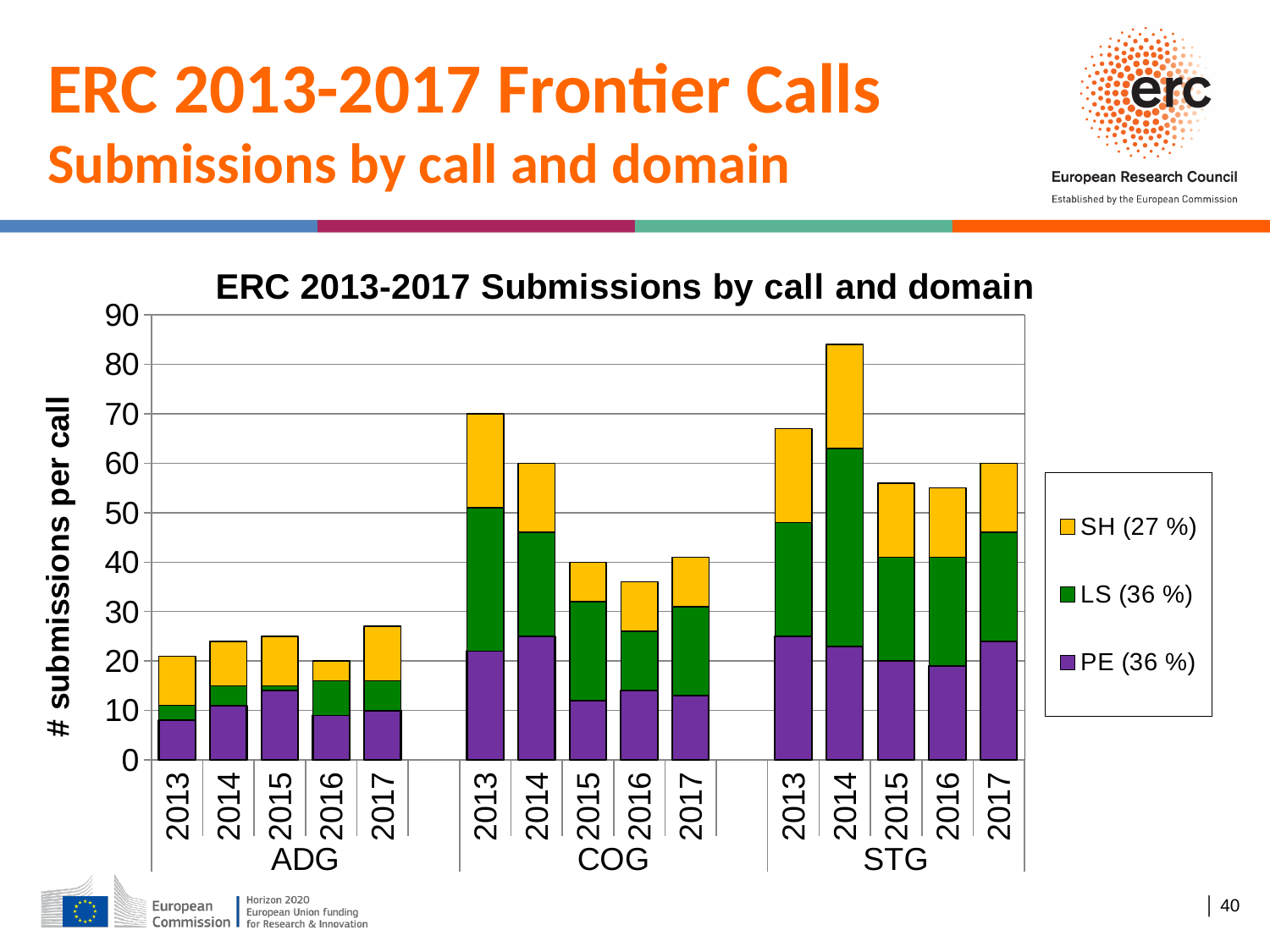
What percentage is shown next to SH in the legend? 27 % Is the total for ADG 2013 greater or less than 30? less How many series does the legend list? 3 How many bars are shown for the ADG call? 5 Which bar is the lowest in the chart? ADG 2016 What is the label of the vertical axis? # submissions per call Which call group has the tallest bar overall? STG 2014 Is the total for STG 2014 greater or less than 80? greater What kind of chart is shown on the slide? stacked bar chart Which is larger, the total for COG 2013 or the total for STG 2013? COG 2013 Is the total for COG 2016 greater or less than 40? less Which is larger, the total for ADG 2017 or the total for COG 2017? COG 2017